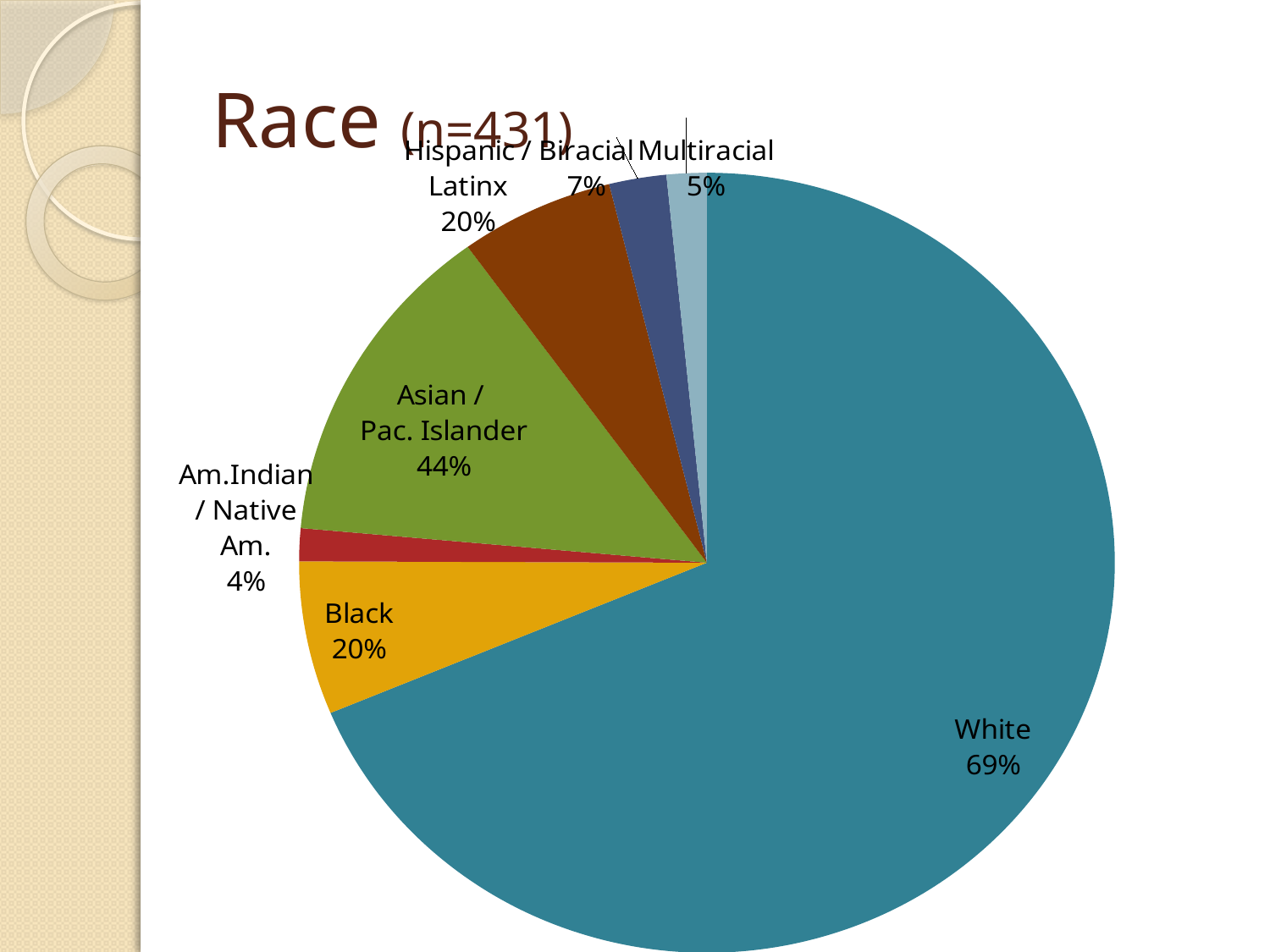
Which has the larger labelled percentage, Asian / Pac. Islander or Hispanic / Latinx? Asian / Pac. Islander What percentage is shown for Biracial? 7% What percentage is shown for Am.Indian / Native Am.? 4% What sample size (n) is given in the chart title? n=431 What kind of chart is shown on the slide? Pie chart What percentage is shown for Multiracial? 5% Which category has the highest percentage in the Race chart? White What percentage is shown for White in the Race pie chart? 69% What percentage is shown for Asian / Pac. Islander? 44% Which category has the lowest percentage in the Race chart? Am.Indian / Native Am. How many race categories are shown in the pie chart? 7 What is the difference in percentage points between White and Black? 49